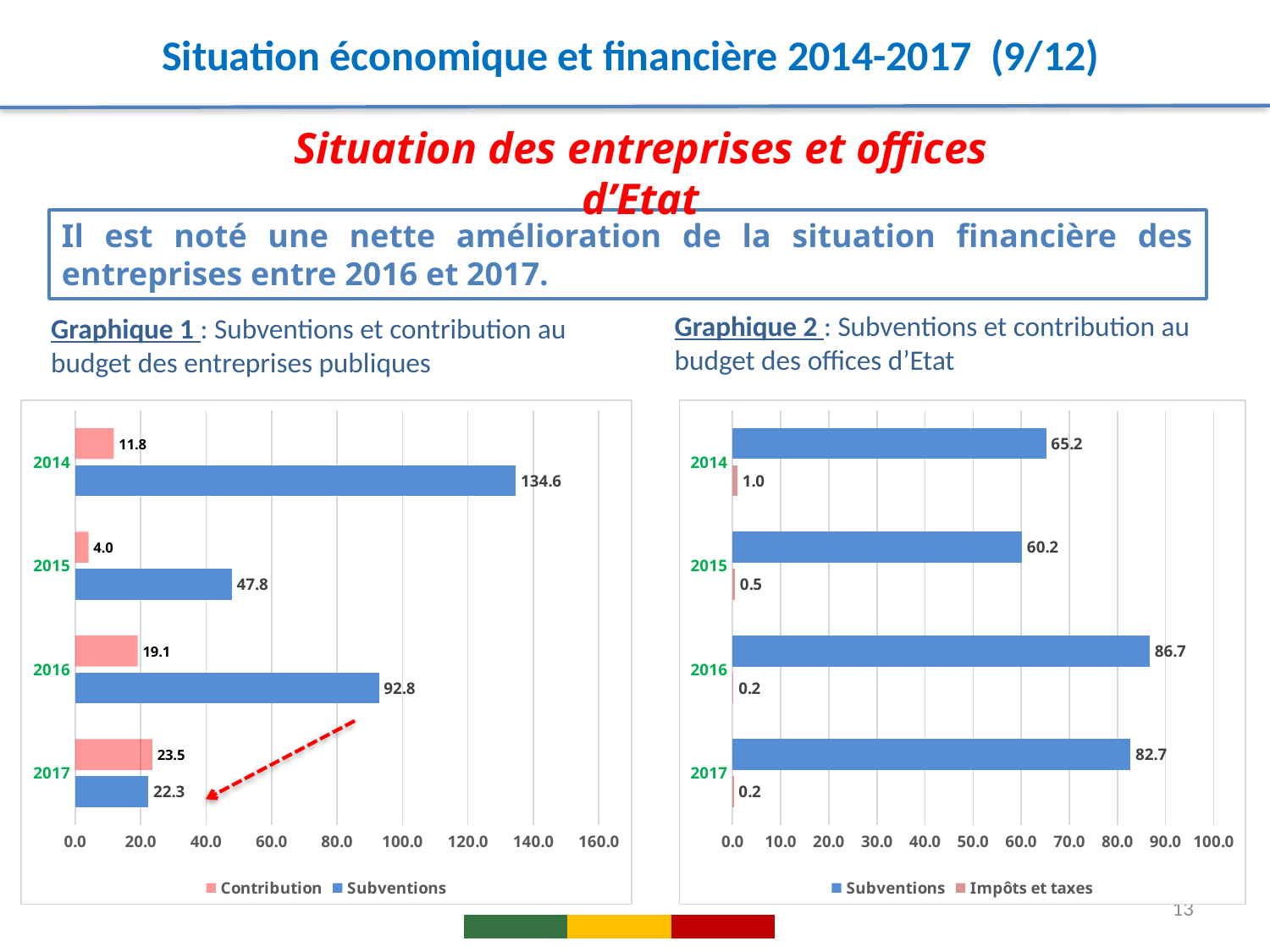
In Graphique 2, what is the difference between the Subventions values for 2014 and 2015? 5.0 How many series does the legend of Graphique 2 list? 2 In Graphique 2, which year has the lowest Subventions value? 2015 In Graphique 1, which is larger for 2017: Contribution or Subventions? Contribution In Graphique 1, which year has the highest Subventions value? 2014 In Graphique 1, what is the Contribution value for 2017? 23.5 In Graphique 1 (Subventions et contribution au budget des entreprises publiques), what is the Subventions value for 2014? 134.6 In Graphique 2, what is the Impôts et taxes value for 2014? 1.0 What kind of chart is Graphique 1? Bar chart In Graphique 2 (Subventions et contribution au budget des offices d'Etat), what is the Subventions value for 2016? 86.7 In Graphique 1, which year has the lowest Contribution value? 2015 In Graphique 1, what is the difference between the Subventions values for 2016 and 2017? 70.5